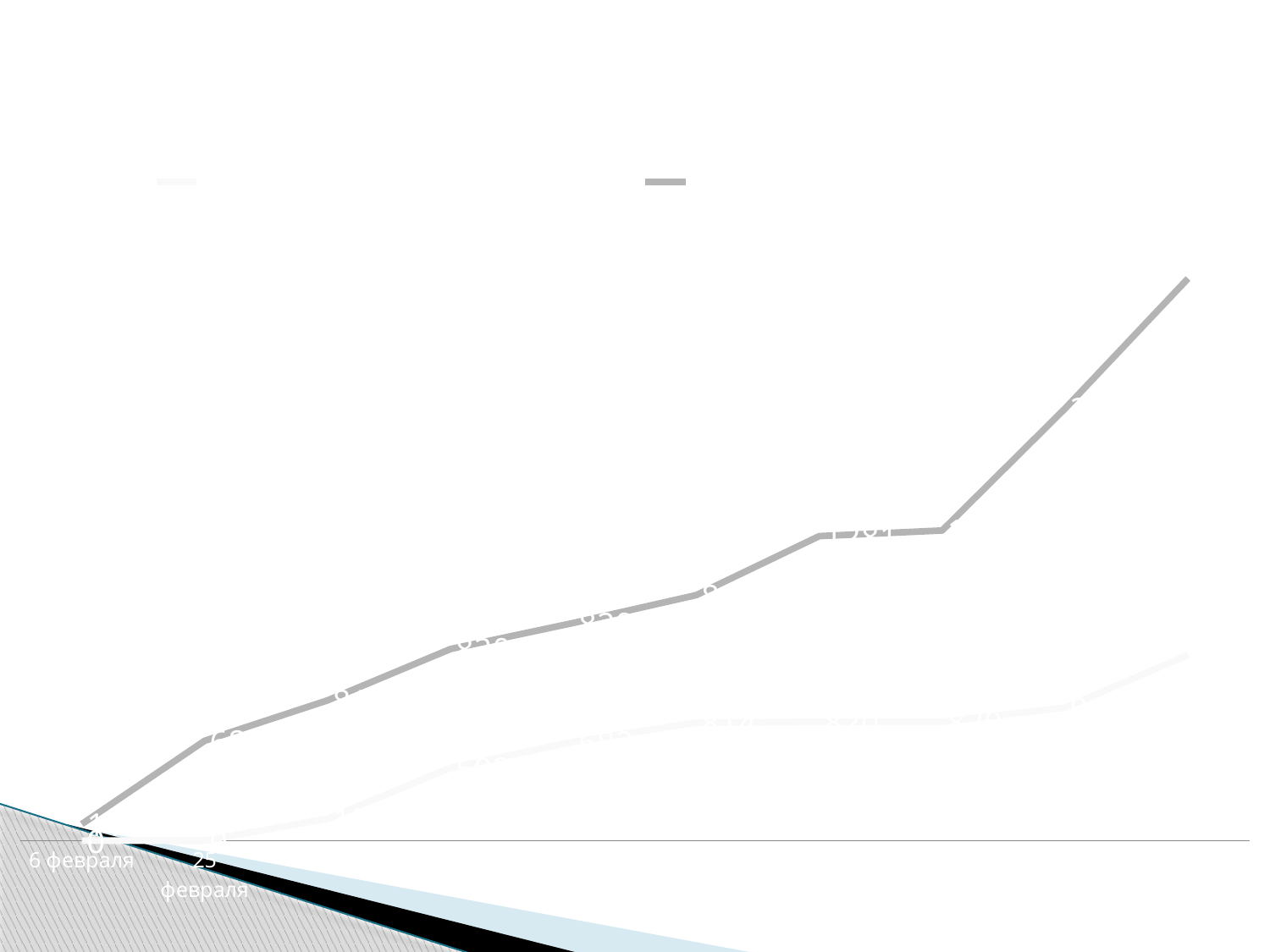
What kind of chart is shown on the slide? line chart What is the first category label on the x axis? 6 февраля How many data points does the gray line have? 10 Does the gray line rise or fall from left to right along the x axis? rises At 25 февраля, which series is higher, the gray line or the white line? the gray line How many series does the legend list? 2